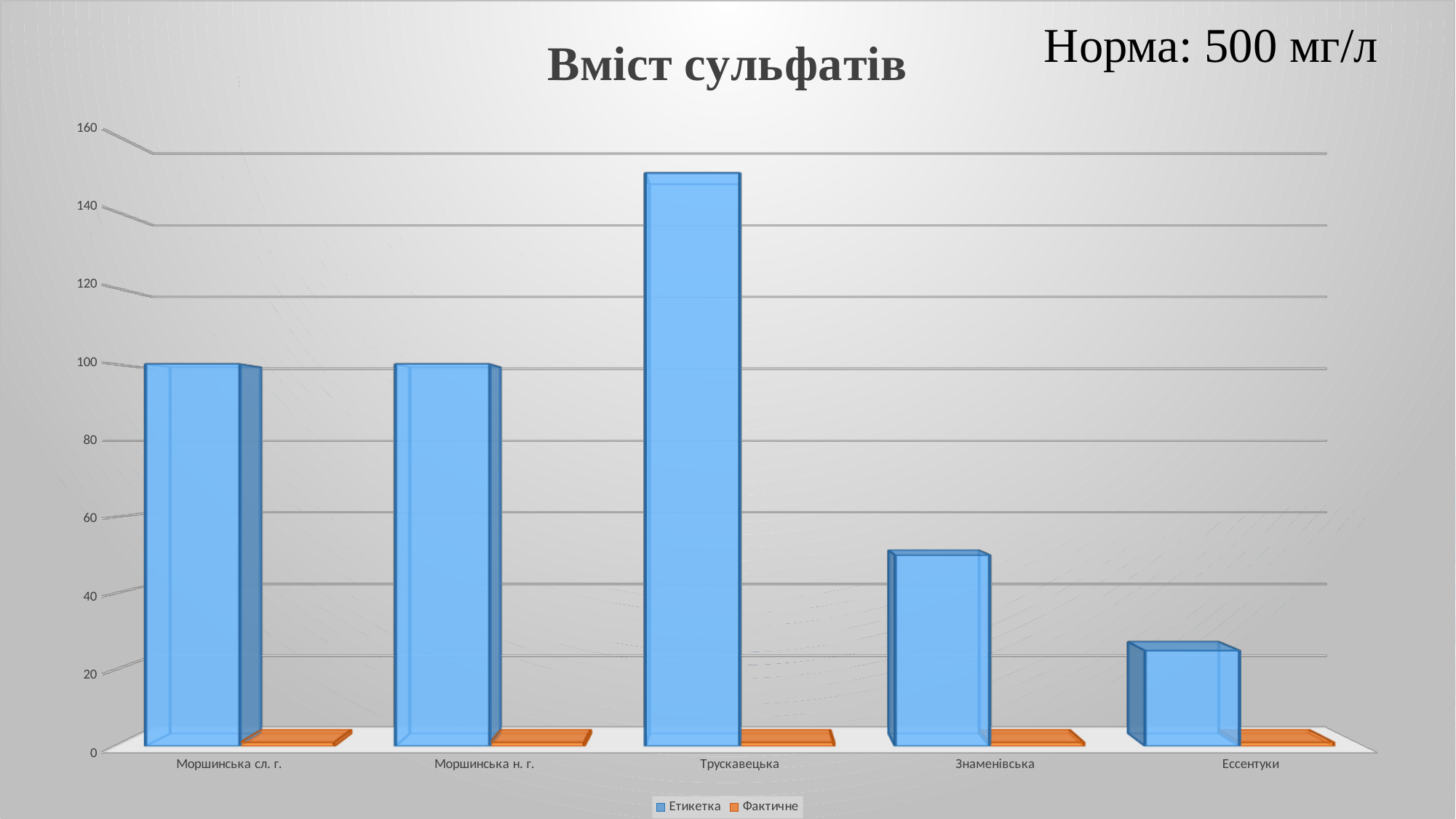
How many series does the legend list? 2 Which category has the highest Етикетка value? Трускавецька Which has the larger Етикетка value, Знаменівська or Ессентуки? Знаменівська Is the Етикетка value for Ессентуки greater or less than 40? less Which has the larger Етикетка value, Трускавецька or Знаменівська? Трускавецька Is the Етикетка value for Трускавецька greater or less than 140? greater Which category has the lowest Етикетка value? Ессентуки What kind of chart is shown on the slide? bar chart What is the title of the chart? Вміст сульфатів Is the Етикетка value for Знаменівська greater or less than 60? less How many categories are shown on the x axis? 5 What are the two series named in the legend? Етикетка and Фактичне